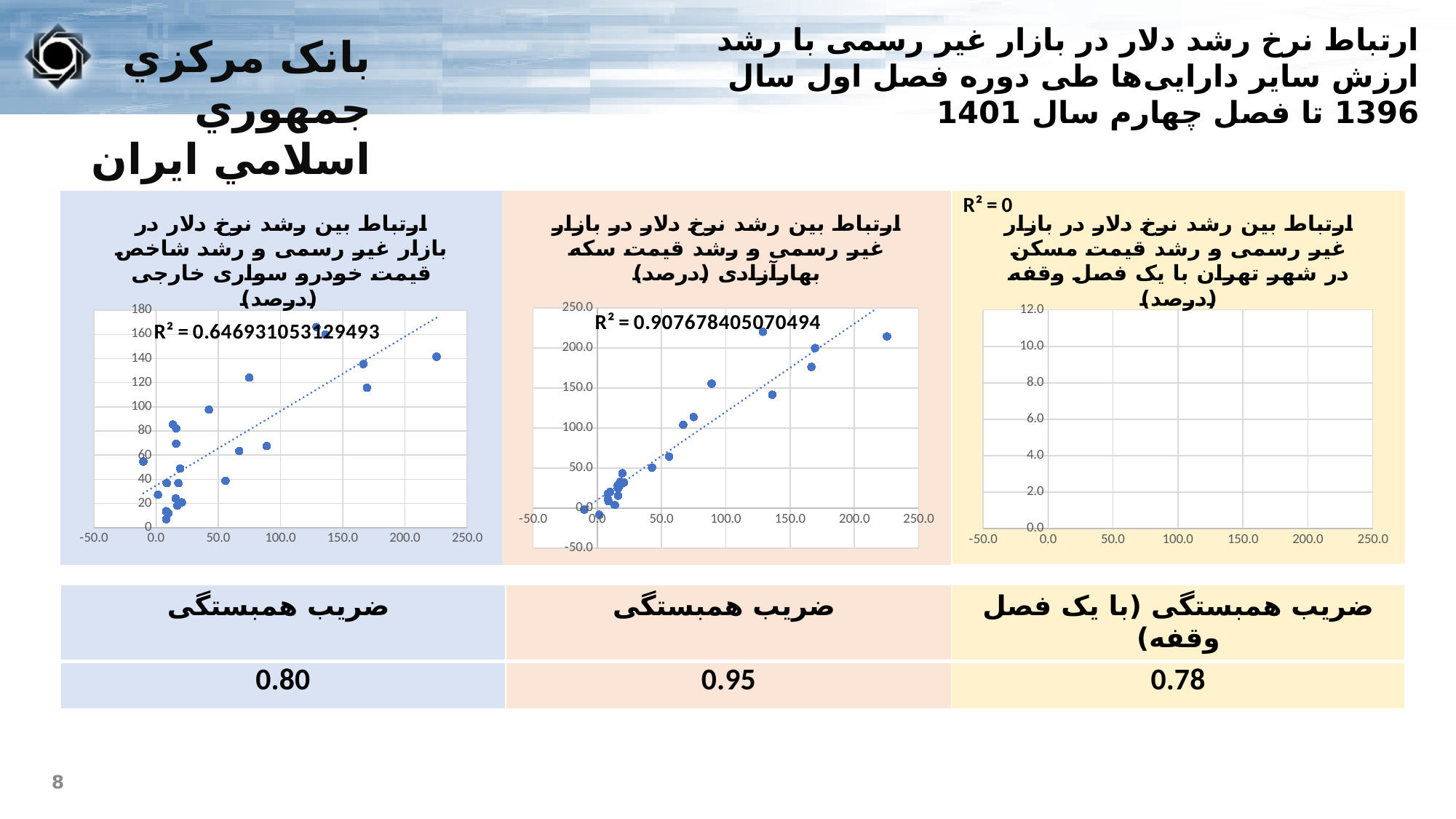
What is the maximum value shown on the y-axis of the left chart? 180 What kind of chart is the left chart (car price index vs. dollar growth)? scatter chart What kind of chart is the middle chart (coin price vs. dollar growth)? scatter chart In the middle chart, is the highest plotted point greater or less than 200.0 on the y-axis? greater In the left chart, is the rightmost plotted point greater or less than 200.0 on the x-axis? greater In the middle chart, is the rightmost plotted point greater or less than 200.0 on the x-axis? greater What is the maximum value shown on the y-axis of the right chart (housing price)? 12.0 In the left chart, do the points generally rise or fall as the x-axis value increases? rise What R² value is printed on the middle chart? R² = 0.907678405070494 In the middle chart, do the points generally rise or fall as the x-axis value increases? rise